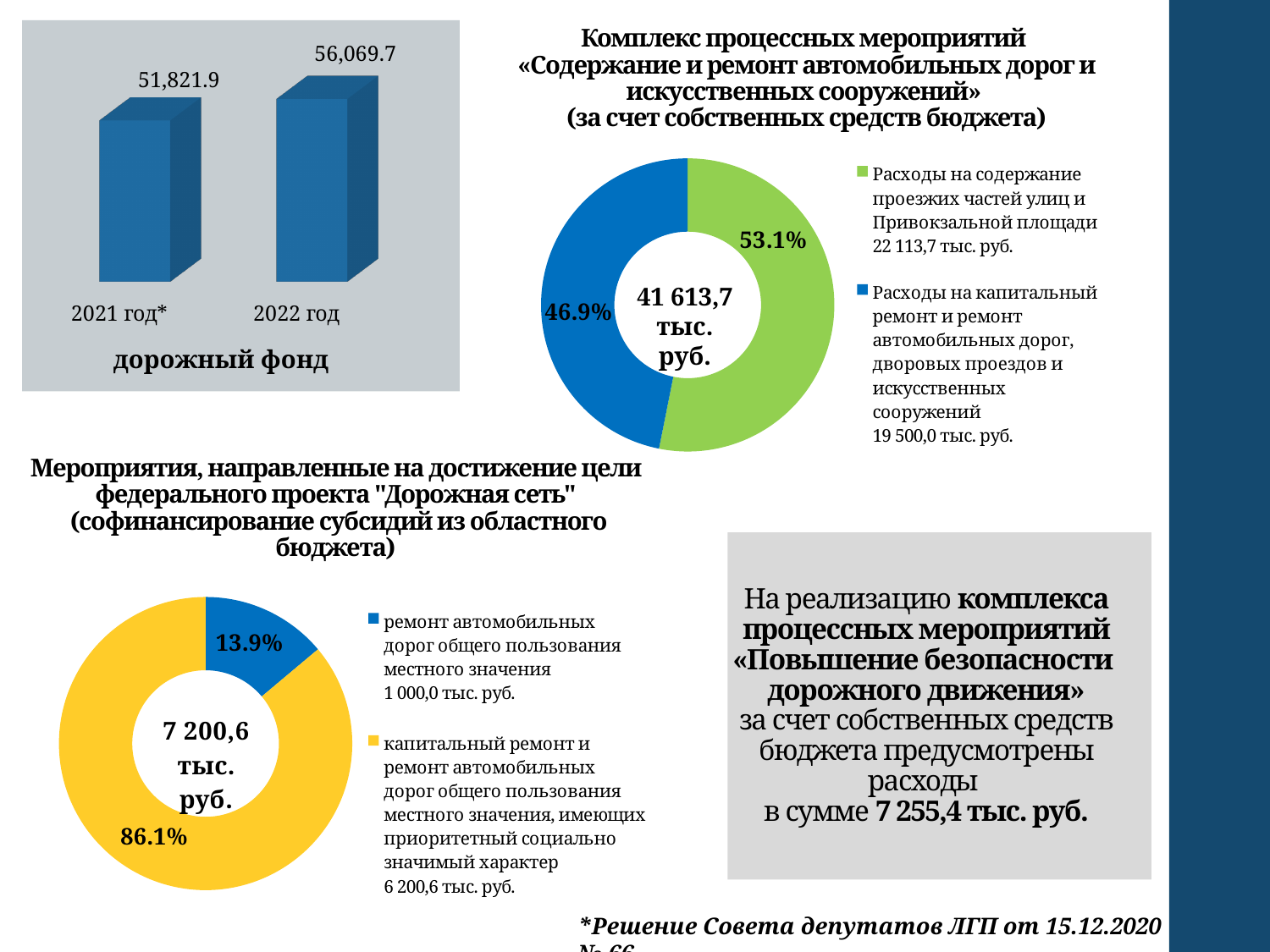
In the bar chart titled "дорожный фонд", what is the difference between the 2022 год and 2021 год* values? 4,247.8 In the bar chart titled "дорожный фонд", what is the value for 2022 год? 56,069.7 In the bar chart titled "дорожный фонд", which year has the higher value? 2022 год What total amount is printed in the centre of the donut chart for "Содержание и ремонт автомобильных дорог и искусственных сооружений"? 41 613,7 тыс. руб. In the donut chart for "Содержание и ремонт автомобильных дорог и искусственных сооружений", what share is shown for "Расходы на капитальный ремонт и ремонт автомобильных дорог, дворовых проездов и искусственных сооружений"? 46.9% In the donut chart for the federal project "Дорожная сеть", which category has the largest share? капитальный ремонт и ремонт автомобильных дорог общего пользования местного значения, имеющих приоритетный социально значимый характер In the bar chart titled "дорожный фонд", do the values rise or fall from 2021 to 2022? rise In the bar chart titled "дорожный фонд", what is the value for 2021 год*? 51,821.9 In the donut chart for the federal project "Дорожная сеть", what share is shown for "ремонт автомобильных дорог общего пользования местного значения"? 13.9% How many categories does the legend of the donut chart for the federal project "Дорожная сеть" list? 2 In the donut chart for "Содержание и ремонт автомобильных дорог и искусственных сооружений", what share is shown for "Расходы на содержание проезжих частей улиц и Привокзальной площади"? 53.1% What kind of chart is the "дорожный фонд" chart in the top-left? bar chart